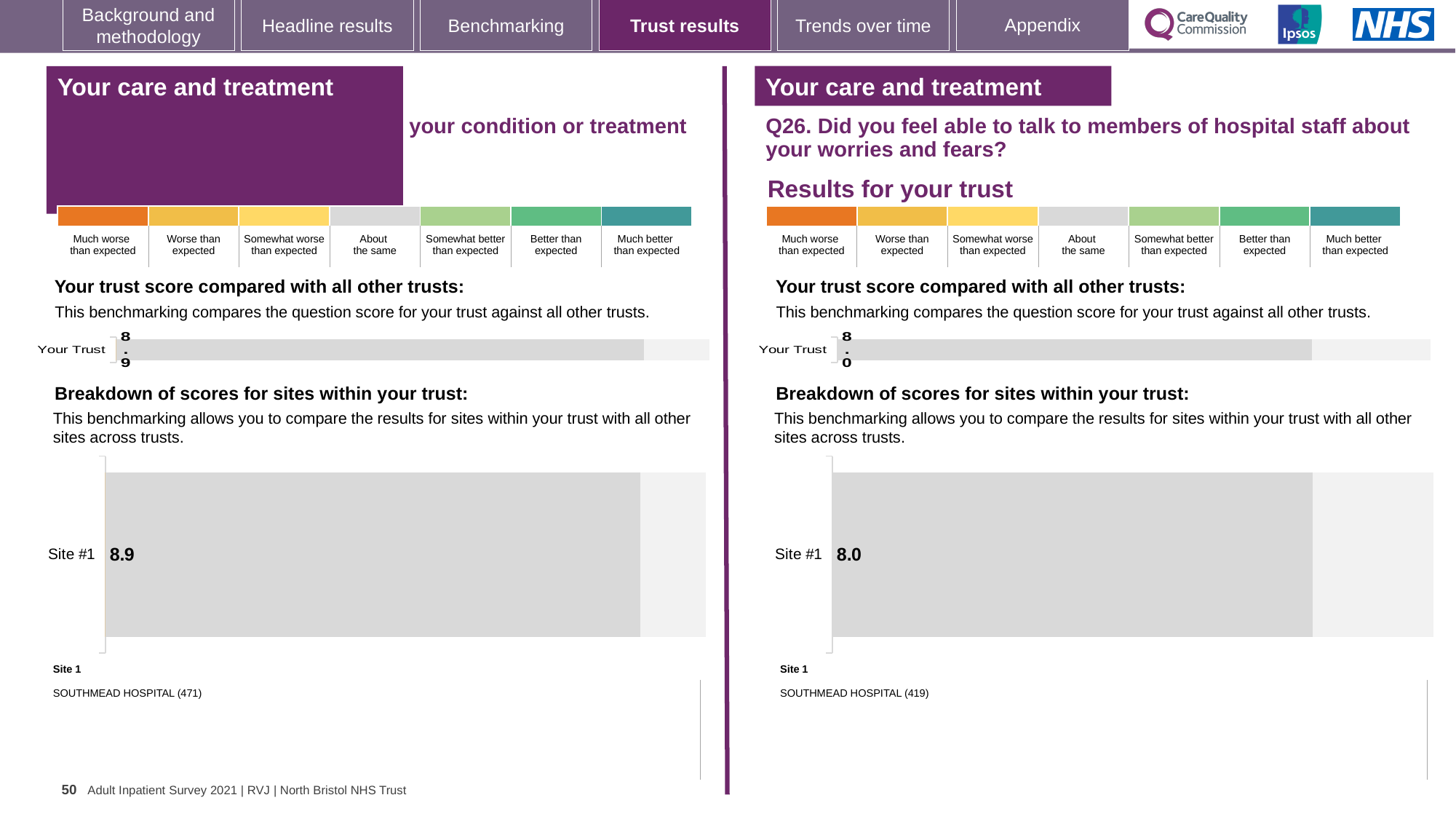
On the left half of the slide, what is the score shown for Your Trust in the 'Your trust score compared with all other trusts' chart? 8.9 On the right half of the slide (Q26), what is the score shown for Your Trust in the 'Your trust score compared with all other trusts' chart? 8.0 On the right half of the slide (Q26), what score is shown for Site #1 in the 'Breakdown of scores for sites within your trust' chart? 8.0 Which hospital is listed as Site 1 beneath the site breakdown chart on the right half of the slide (Q26)? SOUTHMEAD HOSPITAL (419) How many sites are shown in the 'Breakdown of scores for sites within your trust' chart on the right half of the slide (Q26)? 1 What type of chart is used to show the Site #1 score on the left half of the slide? Bar chart Which hospital is listed as Site 1 beneath the site breakdown chart on the left half of the slide? SOUTHMEAD HOSPITAL (471) On the left half of the slide, what score is shown for Site #1 in the 'Breakdown of scores for sites within your trust' chart? 8.9 On the right half of the slide (Q26), is the Site #1 score greater or less than the Your Trust score, or are they equal? Equal What is the difference between the Your Trust score on the left half of the slide and the Your Trust score on the right half (Q26)? 0.9 How many bars are plotted in the 'Your trust score compared with all other trusts' chart on the left half of the slide? 1 Which is larger: the Site #1 score on the left half of the slide or the Site #1 score on the right half (Q26)? Left half (8.9)